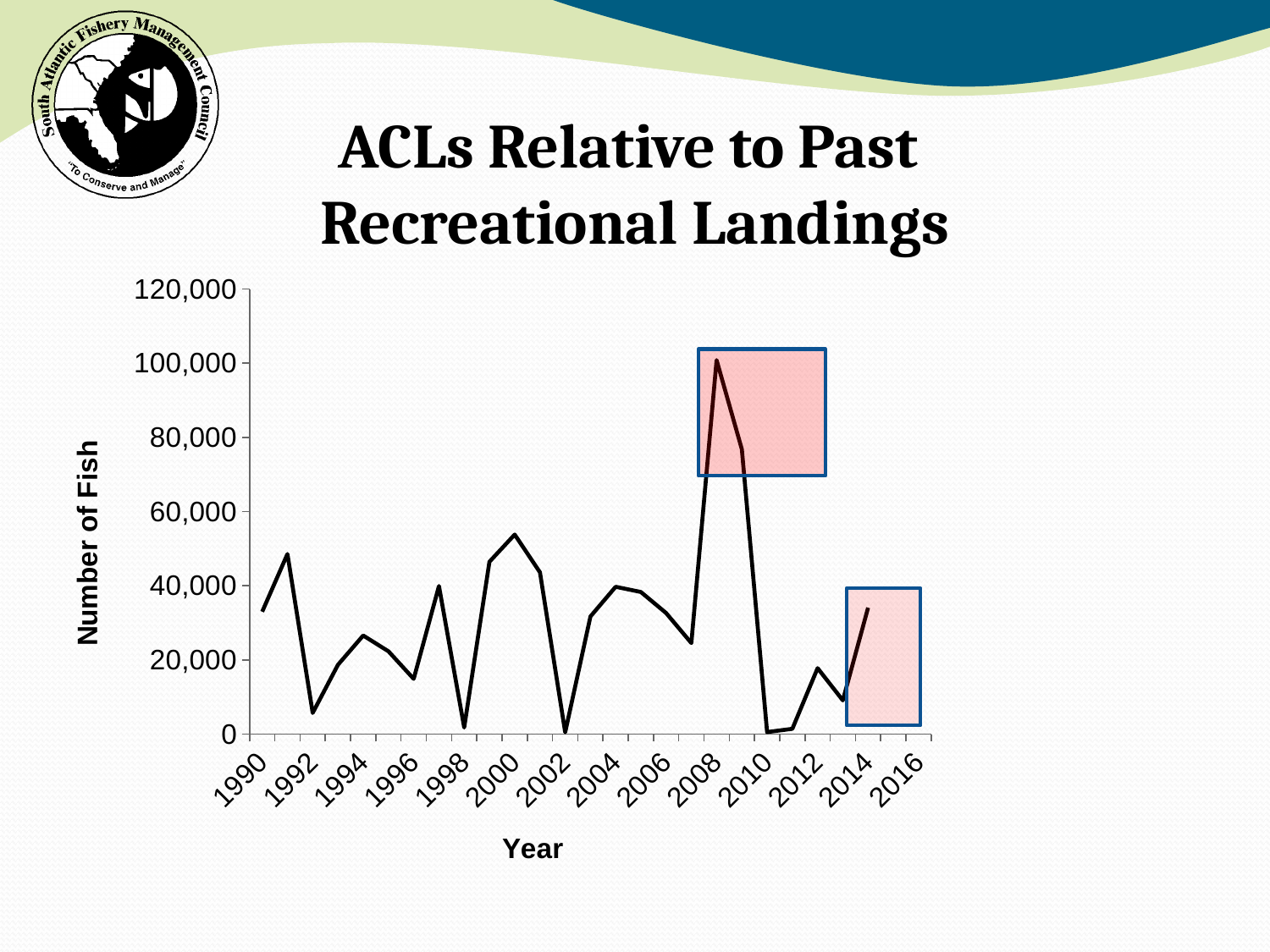
Is the value for 1992 greater or less than 20,000? less What is the title of the chart on the slide? ACLs Relative to Past Recreational Landings Which year has the larger value, 1991 or 1992? 1991 In which year does the line reach its highest value? 2008 Is the value for 2000 greater or less than 40,000? greater Is the value for 2010 greater or less than 20,000? less What is the label of the vertical axis? Number of Fish Does the line rise or fall between 2008 and 2010? fall What kind of chart is shown on the slide? line chart Which year has the larger value, 2008 or 2000? 2008